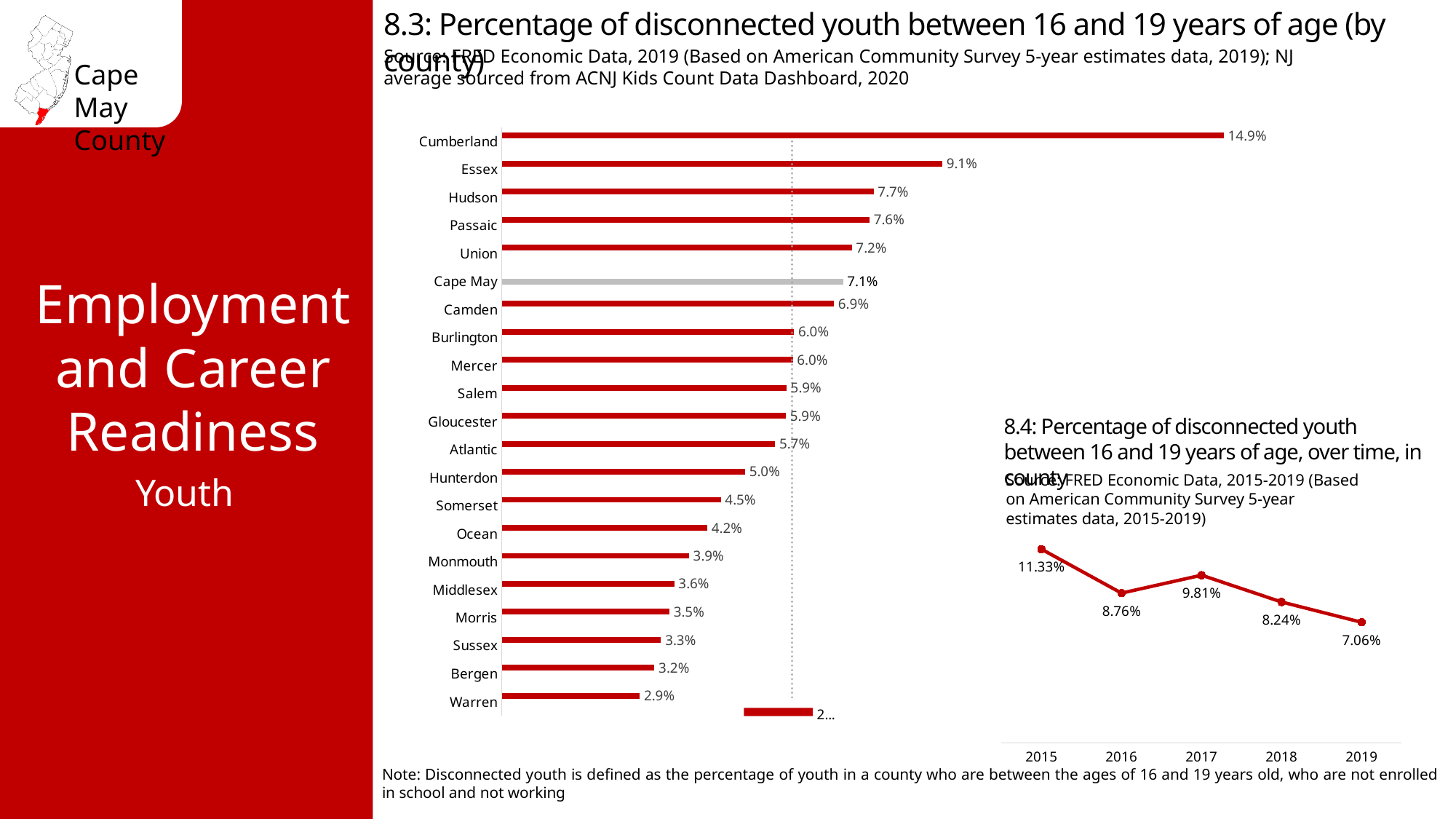
What kind of chart is '8.3: Percentage of disconnected youth between 16 and 19 years of age (by county)'? Bar chart In the chart '8.3: Percentage of disconnected youth between 16 and 19 years of age (by county)', what is the value for Essex? 9.1% In the chart '8.3: Percentage of disconnected youth between 16 and 19 years of age (by county)', what is the difference between Cumberland and Essex? 5.8% In the chart '8.3: Percentage of disconnected youth between 16 and 19 years of age (by county)', which county has the highest value? Cumberland In the chart '8.4: Percentage of disconnected youth between 16 and 19 years of age, over time, in county', what is the difference between the 2017 and 2018 values? 1.57% In the chart '8.4: Percentage of disconnected youth between 16 and 19 years of age, over time, in county', what is the value for 2015? 11.33% In the chart '8.3: Percentage of disconnected youth between 16 and 19 years of age (by county)', which labeled county has the lowest value? Warren In the chart '8.3: Percentage of disconnected youth between 16 and 19 years of age (by county)', what is the value for Cape May? 7.1% In the chart '8.3: Percentage of disconnected youth between 16 and 19 years of age (by county)', which is larger, Hunterdon or Ocean? Hunterdon In the chart '8.3: Percentage of disconnected youth between 16 and 19 years of age (by county)', what colour is the Cape May bar? Gray In the chart '8.4: Percentage of disconnected youth between 16 and 19 years of age, over time, in county', how many data points are plotted? 5 In the chart '8.4: Percentage of disconnected youth between 16 and 19 years of age, over time, in county', which year has the lowest value? 2019